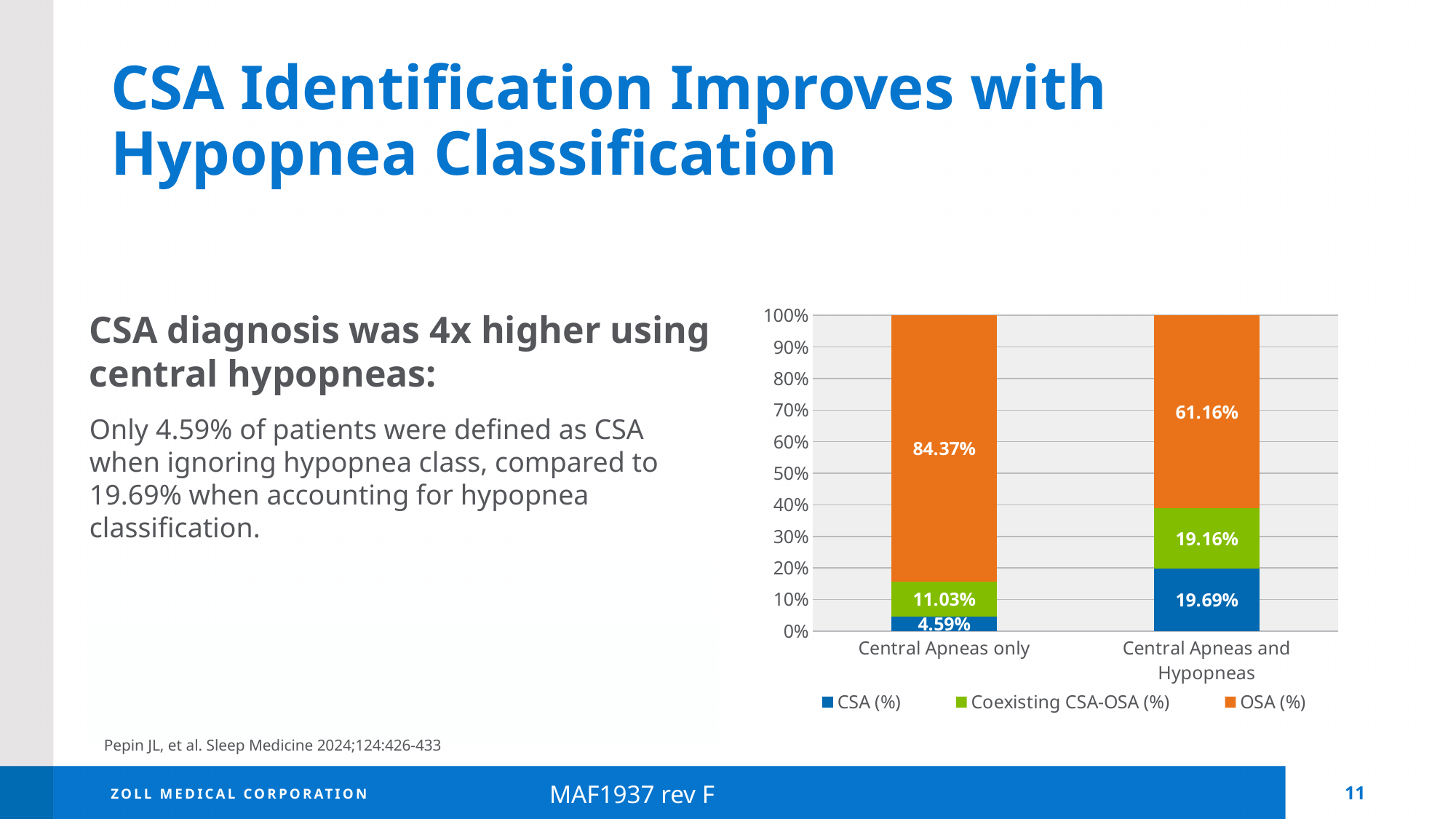
What is the difference between the OSA (%) values for Central Apneas only and Central Apneas and Hypopneas? 23.21% What is the CSA (%) value for Central Apneas and Hypopneas? 19.69% What is the CSA (%) value for Central Apneas only? 4.59% How many series does the chart legend list? 3 Which category has the higher OSA (%) value? Central Apneas only Which category has the lower CSA (%) value? Central Apneas only How many categories are shown on the x axis of the chart? 2 What is the OSA (%) value for Central Apneas and Hypopneas? 61.16% What kind of chart is shown on the slide? Stacked bar chart What is the Coexisting CSA-OSA (%) value for Central Apneas only? 11.03% Which colour represents OSA (%) in the chart? Orange Is the Coexisting CSA-OSA (%) value larger for Central Apneas only or for Central Apneas and Hypopneas? Central Apneas and Hypopneas